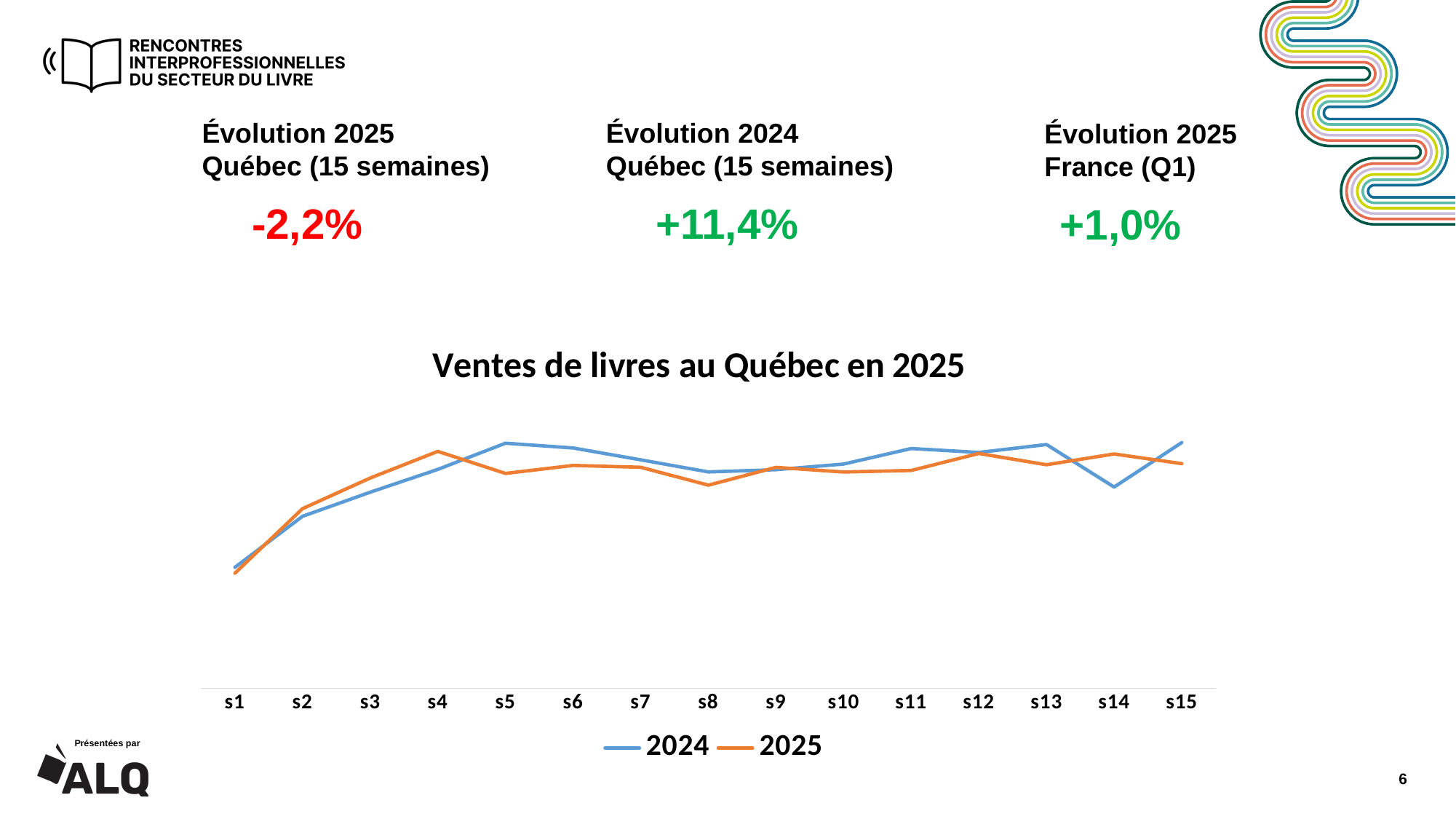
At s14, which series has the higher value, 2024 or 2025? 2025 For the 2024 series, which week has the lowest value? s1 At s5, which series has the higher value, 2024 or 2025? 2024 At s4, which series has the higher value, 2024 or 2025? 2025 What kind of chart is shown under the title "Ventes de livres au Québec en 2025"? line chart For the 2025 series, which week has the lowest value? s1 How many series does the legend of the chart list? 2 What is the title of the chart? Ventes de livres au Québec en 2025 Does the 2025 series rise or fall from s1 to s4? rise Which series is drawn in orange in the chart? 2025 How many weeks (points) are plotted along the x axis of the chart? 15